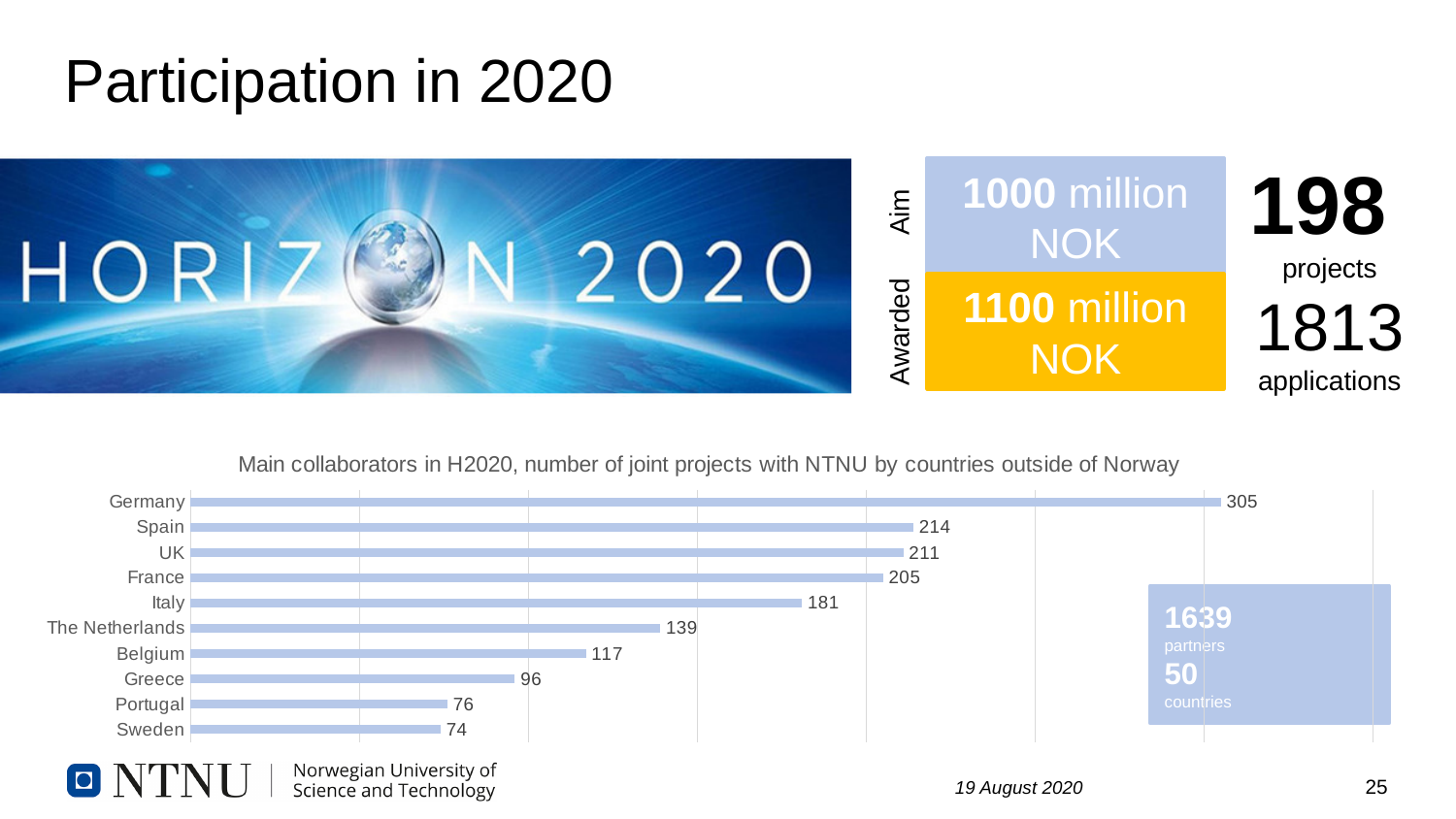
Which has a larger value in the chart, Portugal or Greece? Greece What is the difference between the values for Germany and Spain in the chart? 91 Which country has the highest number of joint projects with NTNU in the chart? Germany Which country has the lowest number of joint projects with NTNU in the chart? Sweden What is the value for Germany in the chart 'Main collaborators in H2020, number of joint projects with NTNU by countries outside of Norway'? 305 How many joint projects with NTNU does the chart show for The Netherlands? 139 How many countries are shown in the bar chart? 10 What is the difference between the values for Italy and Belgium in the chart? 64 Which has a larger value in the chart, France or Italy? France What is the title of the chart at the bottom of the slide? Main collaborators in H2020, number of joint projects with NTNU by countries outside of Norway What kind of chart is used to show the main collaborators in H2020? Bar chart What is the value shown for Greece in the bar chart? 96